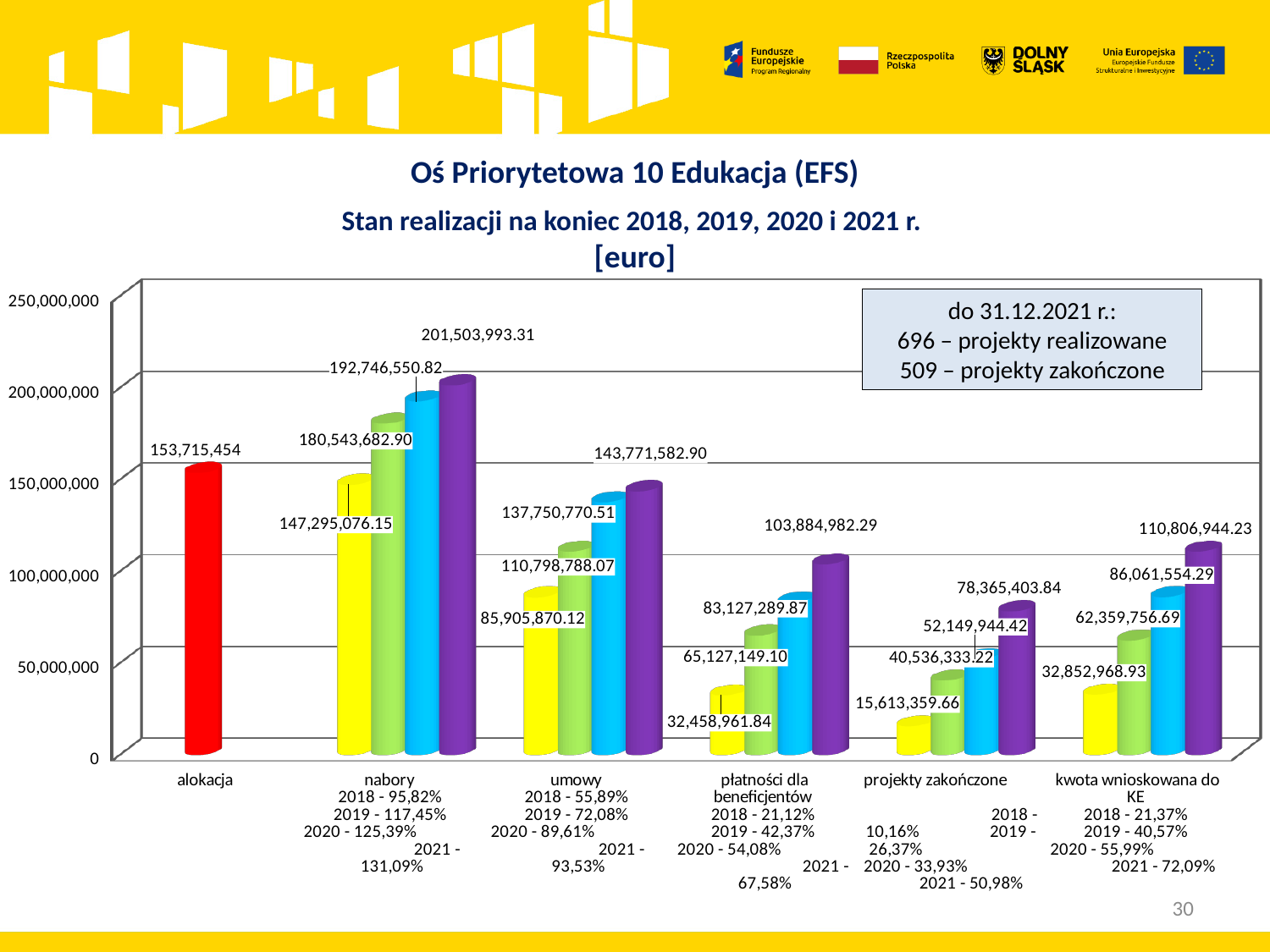
What is the difference between the tallest nabory bar (201,503,993.31) and the alokacja bar (153,715,454)? 47,788,539.31 Is the tallest bar in the kwota wnioskowana do KE group greater or less than 100,000,000? greater Which is larger: the alokacja bar or the tallest bar in the umowy group? alokacja What is the value of the shortest bar in the umowy group? 85,905,870.12 What percentage is listed for 2021 under the nabory category label? 131,09% What type of chart is shown on the slide? bar chart How many categories are shown along the x axis of the chart? 6 Within each category group, do the bars rise or fall from left to right? rise What is the value of the shortest bar in the płatności dla beneficjentów group? 32,458,961.84 What is the value of the alokacja bar? 153,715,454 What is the value of the tallest bar in the projekty zakończone group? 78,365,403.84 What is the value of the tallest bar in the nabory group? 201,503,993.31